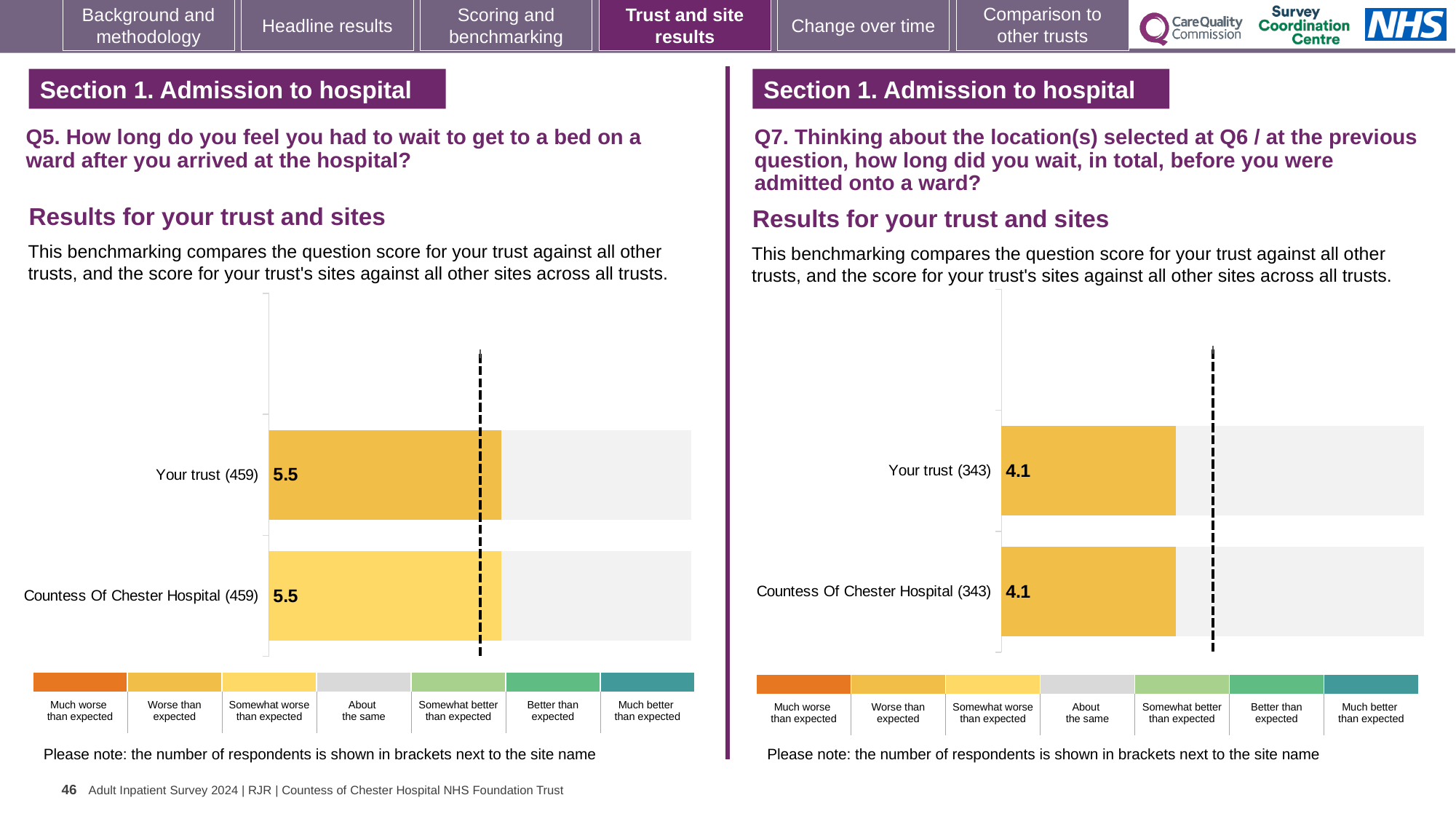
On the left chart (Q5), what is the score for Countess Of Chester Hospital? 5.5 On the left chart (Q5), how many respondents are shown in brackets for Your trust? 459 What kind of chart is used on the left (Q5)? Bar chart On the left chart (Q5), what is the difference between the score for Your trust and the score for Countess Of Chester Hospital? 0.0 On the left chart (Q5), what is the score for Your trust? 5.5 How many categories does the colour key below the right chart (Q7) list? 7 How many bars are plotted on the left chart (Q5)? 2 On the right chart (Q7), how many respondents are shown in brackets for Countess Of Chester Hospital? 343 How many bars are plotted on the right chart (Q7)? 2 On the right chart (Q7), what is the score for Your trust? 4.1 On the right chart (Q7), what is the score for Countess Of Chester Hospital? 4.1 On the right chart (Q7), what is the difference between the score for Your trust and the score for Countess Of Chester Hospital? 0.0